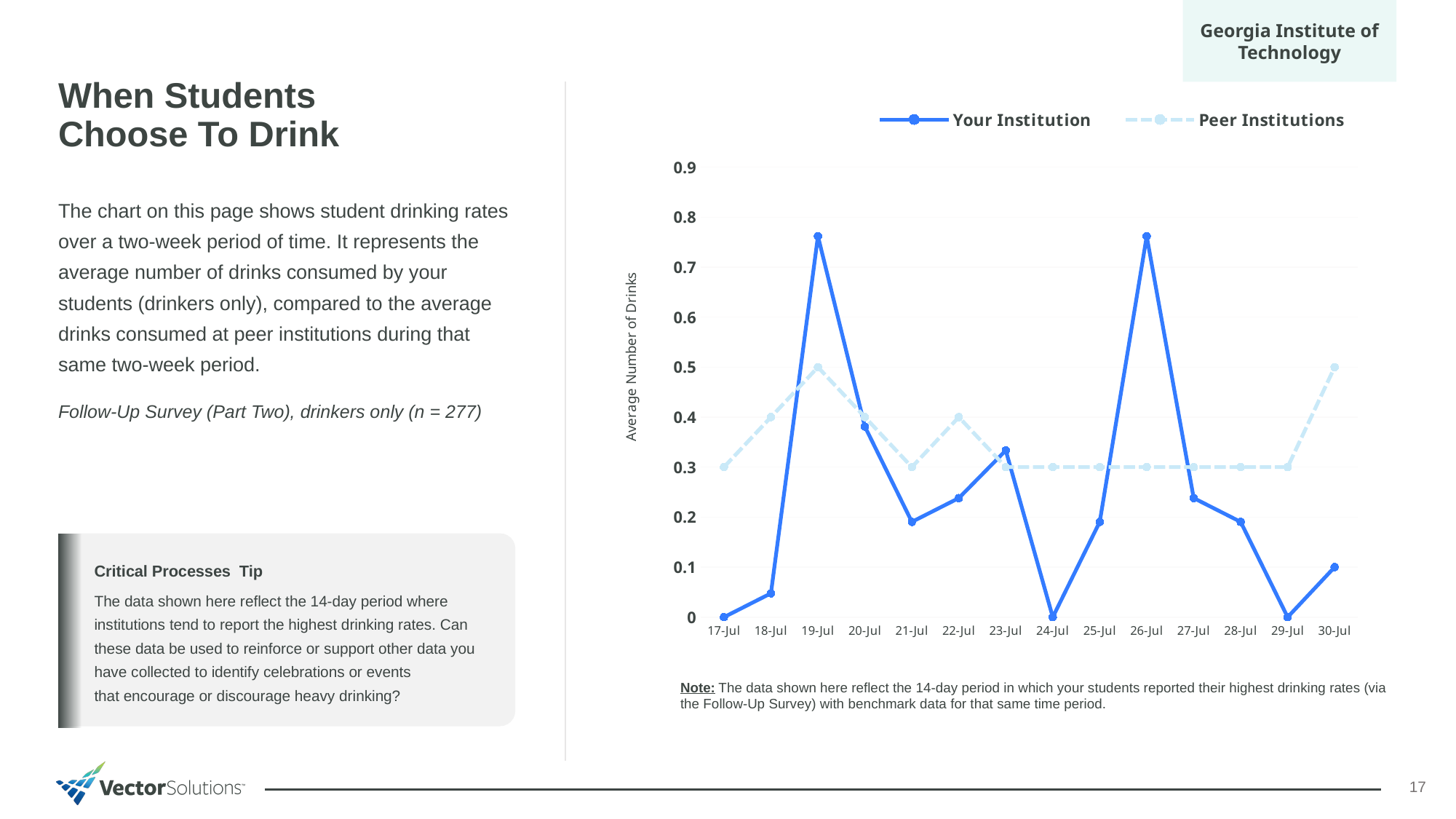
What kind of chart is shown on the slide? line chart What is the value for Your Institution on 24-Jul? 0 How many dates are plotted along the x axis of the chart? 14 Does the Your Institution line rise or fall from 26-Jul to 29-Jul? fall On 24-Jul, which series has the higher value, Your Institution or Peer Institutions? Peer Institutions What is the value for Peer Institutions on 30-Jul? 0.5 Is the value for Your Institution on 22-Jul greater or less than 0.3? less What is the value for Peer Institutions on 19-Jul? 0.5 Is the value for Your Institution on 19-Jul greater or less than 0.7? greater How many series does the chart legend list? 2 What is the value for Peer Institutions on 17-Jul? 0.3 On 19-Jul, which series has the higher value, Your Institution or Peer Institutions? Your Institution